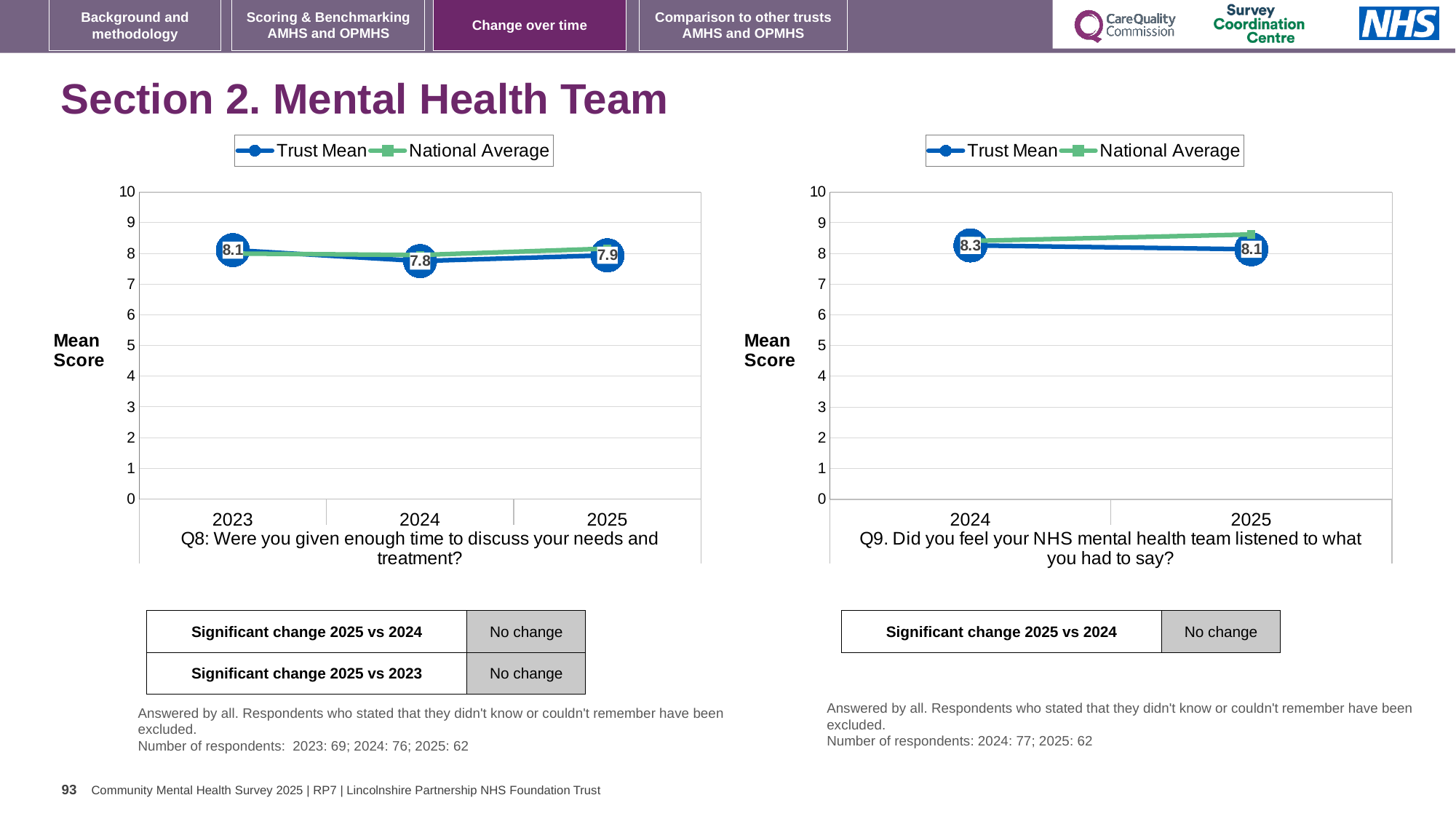
On the left chart (Q8), what is the Trust Mean for 2023? 8.1 On the right chart (Q9), is the Trust Mean higher in 2024 or in 2025? 2024 How many years are plotted on the left chart (Q8)? 3 On the right chart (Q9), what is the Trust Mean for 2025? 8.1 On the left chart (Q8), what is the difference between the Trust Mean in 2023 and in 2024? 0.3 What type of chart is used for Q8 on the left? Line chart On the left chart (Q8), which year has the lowest Trust Mean? 2024 On the right chart (Q9), what is the Trust Mean for 2024? 8.3 How many series does the legend of the right chart (Q9) list? 2 On the left chart (Q8), what is the Trust Mean for 2024? 7.8 On the left chart (Q8), what is the Trust Mean for 2025? 7.9 On the right chart (Q9), what is the difference between the Trust Mean in 2024 and in 2025? 0.2